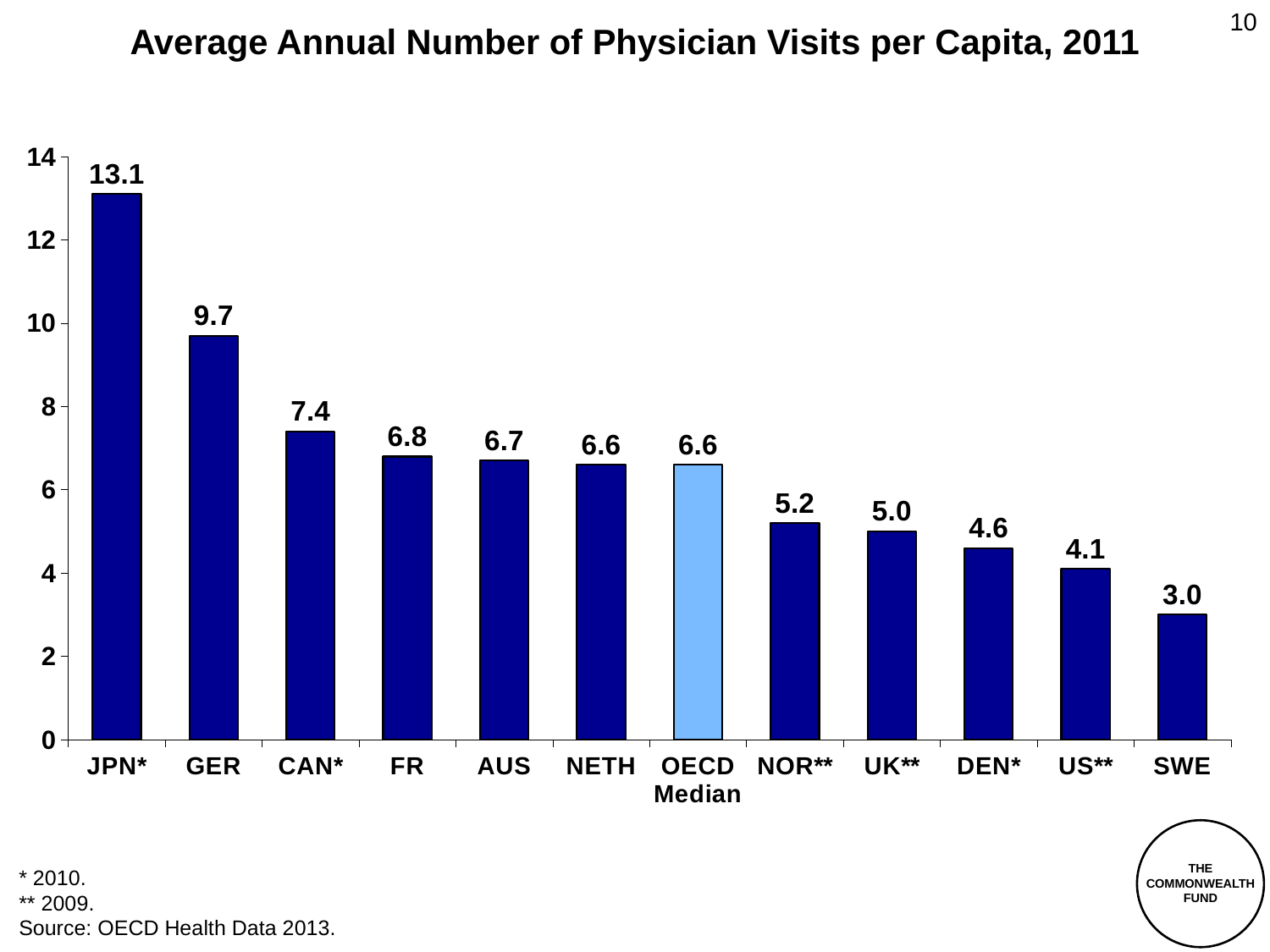
What is the difference between the values for JPN* and GER? 3.4 Which has a higher value, CAN* or NOR**? CAN* Which country has the lowest number of physician visits per capita? SWE Which country has the highest number of physician visits per capita? JPN* What kind of chart is shown on the slide? bar chart What is the value shown for US**? 4.1 How many bars are shown in the chart? 12 What is the average annual number of physician visits per capita for JPN*? 13.1 Which bar is shown in a lighter blue colour than the others? OECD Median Is the value for DEN* greater or less than 6? less What is the difference between the values for UK** and US**? 0.9 What is the value shown for the OECD Median? 6.6